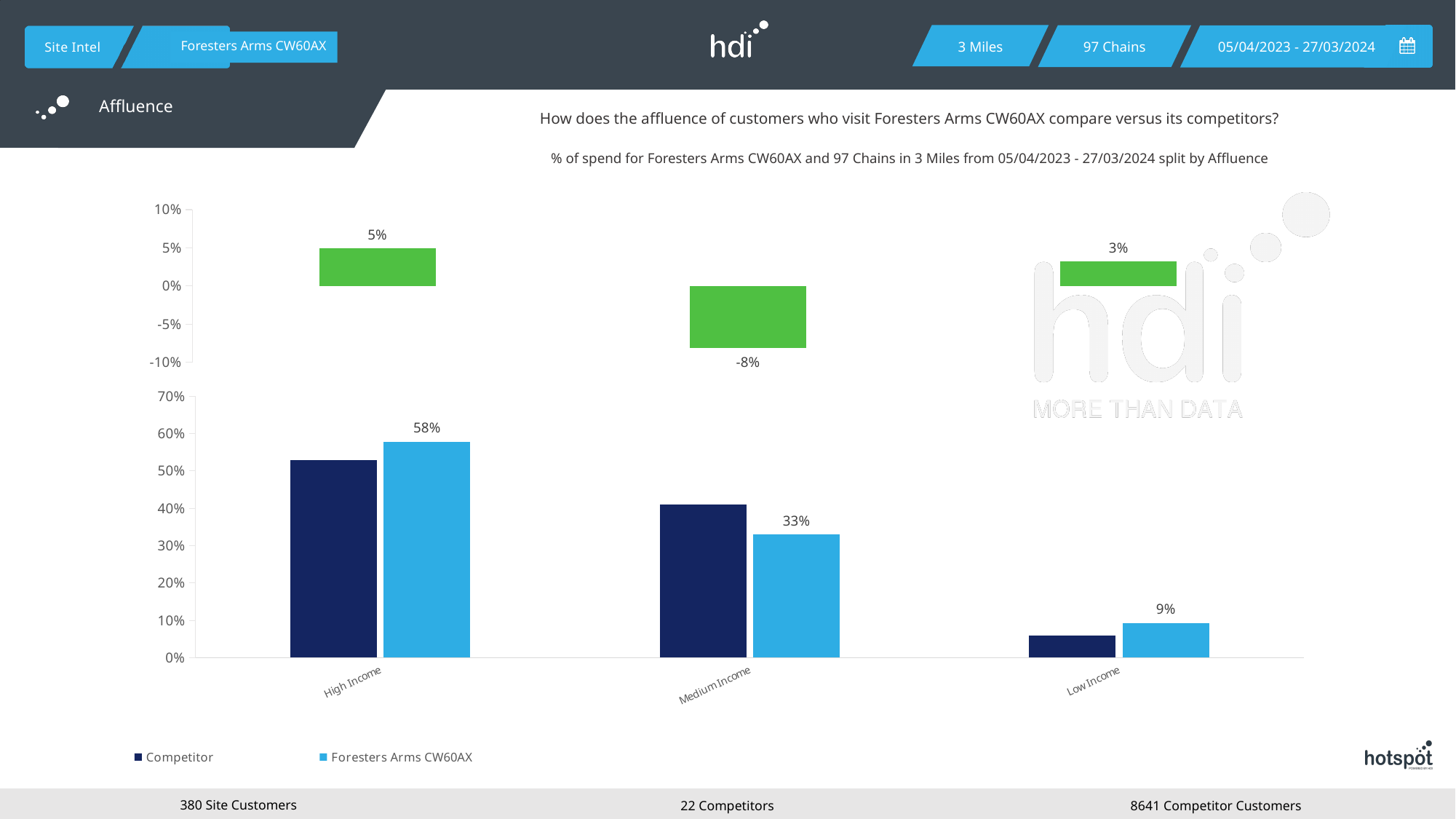
In the top chart, what is the value shown for the High Income category? 5% In the top chart, what is the value shown for the Medium Income category? -8% In the top chart, which category has the lowest value? Medium Income In the bottom bar chart, what is the difference between the Foresters Arms CW60AX values for High Income and Medium Income? 25% In the bottom bar chart, what is the value for Foresters Arms CW60AX in the Low Income category? 9% In the bottom bar chart, which category has the highest value for Foresters Arms CW60AX? High Income In the bottom bar chart, what is the value for Foresters Arms CW60AX in the Medium Income category? 33% How many series does the legend of the bottom bar chart list? 2 In the bottom bar chart, what is the value for Foresters Arms CW60AX in the High Income category? 58% What kind of chart is the bottom chart? Bar chart In the bottom bar chart, is the Competitor value for High Income greater or less than 50%? greater In the bottom bar chart, which is larger in the Medium Income category: Competitor or Foresters Arms CW60AX? Competitor